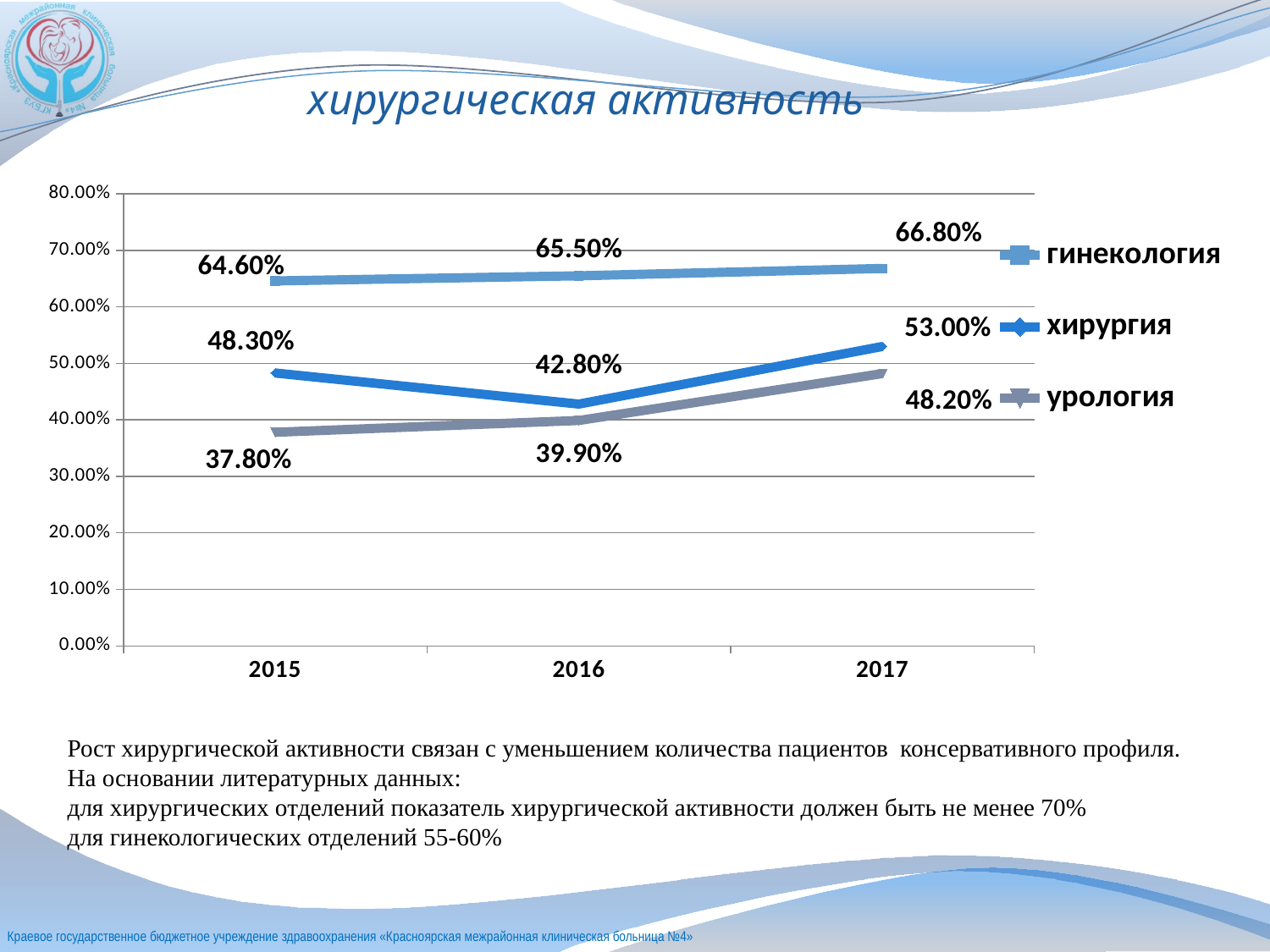
What is the value for урология in 2017? 48.20% What is the difference between the гинекология values in 2017 and 2015? 2.20% Which series has the highest value in 2017? гинекология What is the value for хирургия in 2017? 53.00% How many series does the legend list? 3 What type of chart is shown on the slide? line chart Which is larger in 2016: the value for хирургия or the value for урология? хирургия Does the value for урология rise or fall from 2015 to 2017? rise How many years are shown on the x axis? 3 Which series has the lowest value in 2015? урология What is the value for гинекология in 2015? 64.60% What is the value for хирургия in 2016? 42.80%